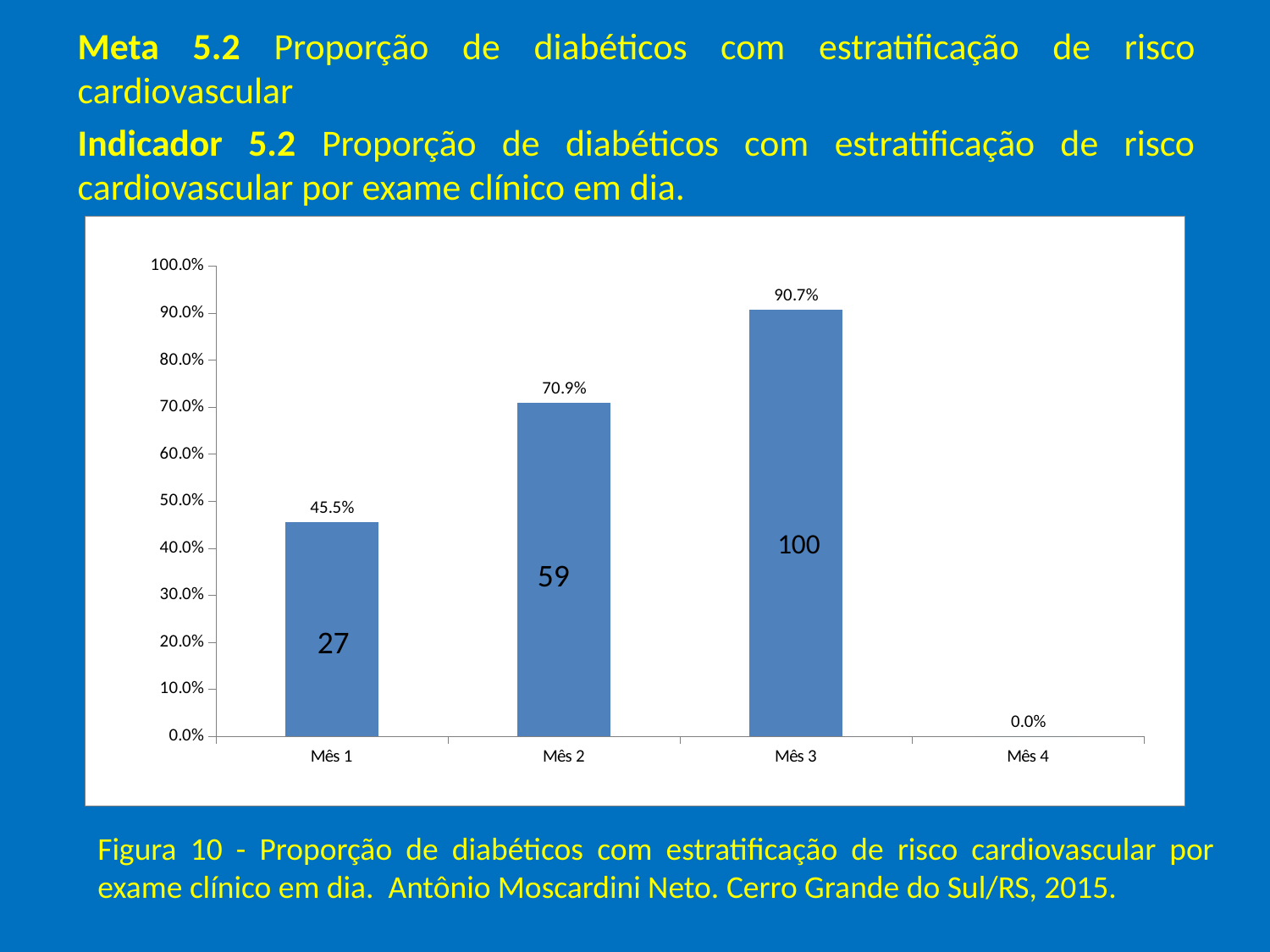
Which month has the lowest value? Mês 4 Which is larger, the value for Mês 2 or the value for Mês 3? Mês 3 Which month has the highest value? Mês 3 What is the difference between the values for Mês 3 and Mês 1? 45.2% What is the difference between the values for Mês 2 and Mês 1? 25.4% What number is printed inside the bar for Mês 2? 59 What is the value for Mês 3? 90.7% What is the value for Mês 1? 45.5% What is the value for Mês 4? 0.0% What kind of chart is shown on the slide? Bar chart How many months are shown on the x axis? 4 What is the value for Mês 2? 70.9%